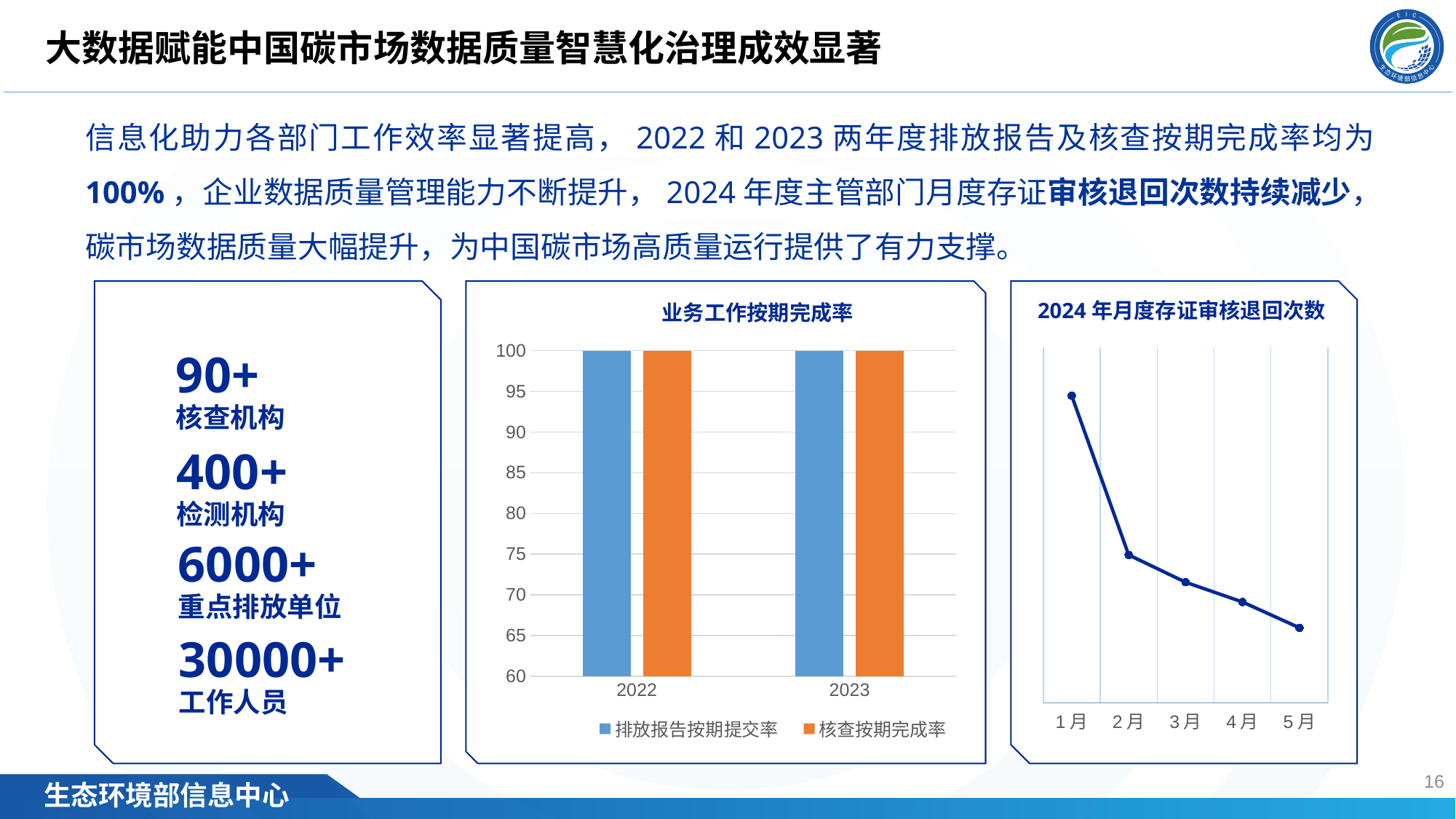
In the chart titled 业务工作按期完成率, which colour represents 核查按期完成率? orange In the chart titled 2024年月度存证审核退回次数, do the values rise or fall from 1月 to 5月? fall In the chart titled 业务工作按期完成率, how many series does the legend list? 2 What kind of chart is the one titled 2024年月度存证审核退回次数? line chart In the chart titled 业务工作按期完成率, what is the difference between the 排放报告按期提交率 values for 2022 and 2023? 0 In the chart titled 业务工作按期完成率, how many years are shown on the x axis? 2 In the chart titled 2024年月度存证审核退回次数, which month has the highest value? 1月 What kind of chart is the one titled 业务工作按期完成率? bar chart In the chart titled 业务工作按期完成率, is the value of 核查按期完成率 for 2022 greater or less than 90? greater In the chart titled 业务工作按期完成率, what is the value of 核查按期完成率 for 2023? 100 In the chart titled 业务工作按期完成率, what is the value of 排放报告按期提交率 for 2022? 100 In the chart titled 2024年月度存证审核退回次数, how many months are plotted? 5